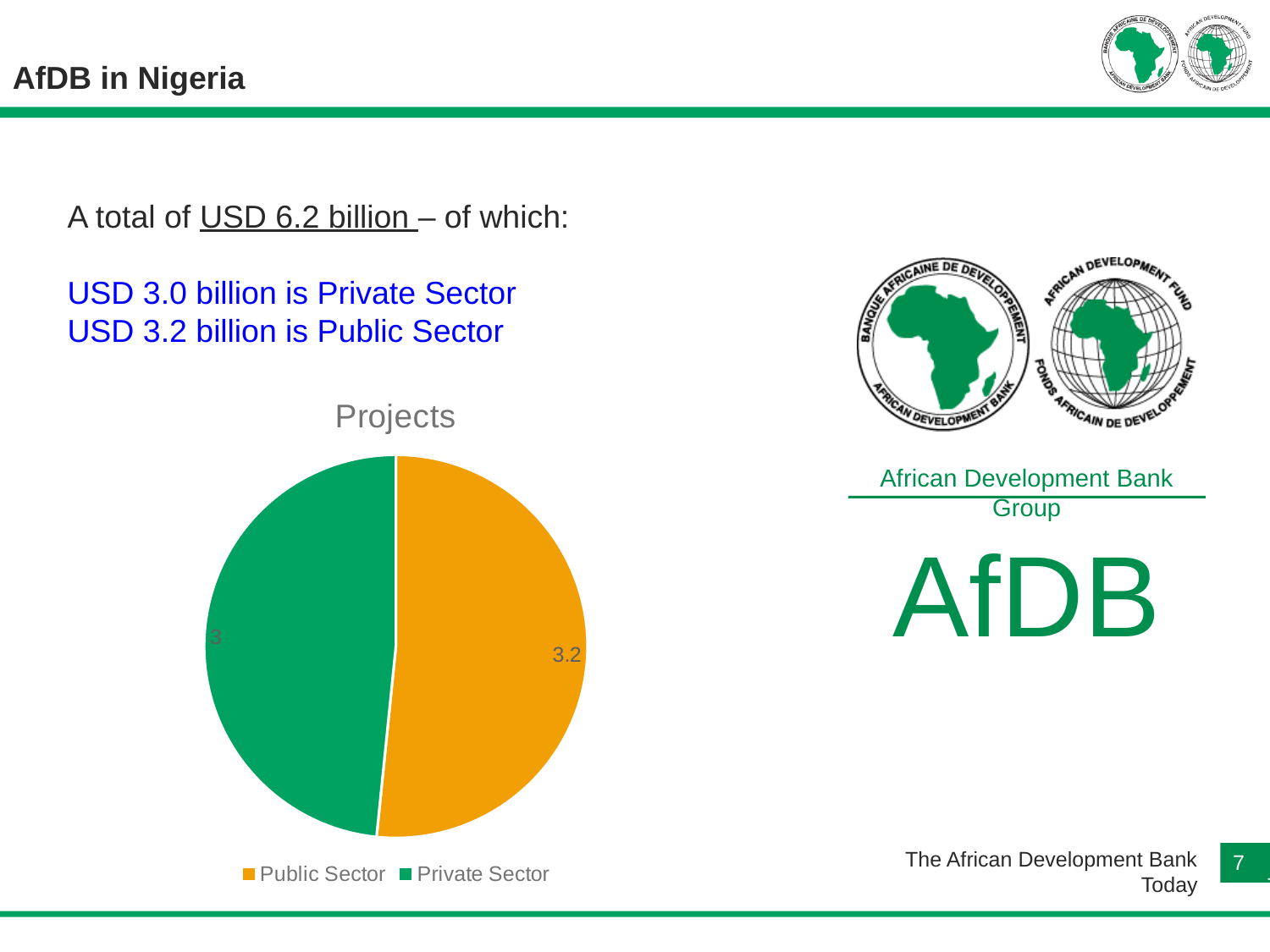
What is the difference between the Public Sector and Private Sector values? 0.2 What colour is the Public Sector slice? orange Is the Private Sector value larger or smaller than the Public Sector value? smaller How many slices does the pie chart have? 2 What is the value shown for the Public Sector slice? 3.2 What type of chart is shown on the slide? pie chart Which slice has the larger value? Public Sector How many entries does the legend list? 2 What is the title of the chart? Projects Which slice has the smaller value? Private Sector What is the value shown for the Private Sector slice? 3 What is the total of the two slice values in the pie chart? 6.2